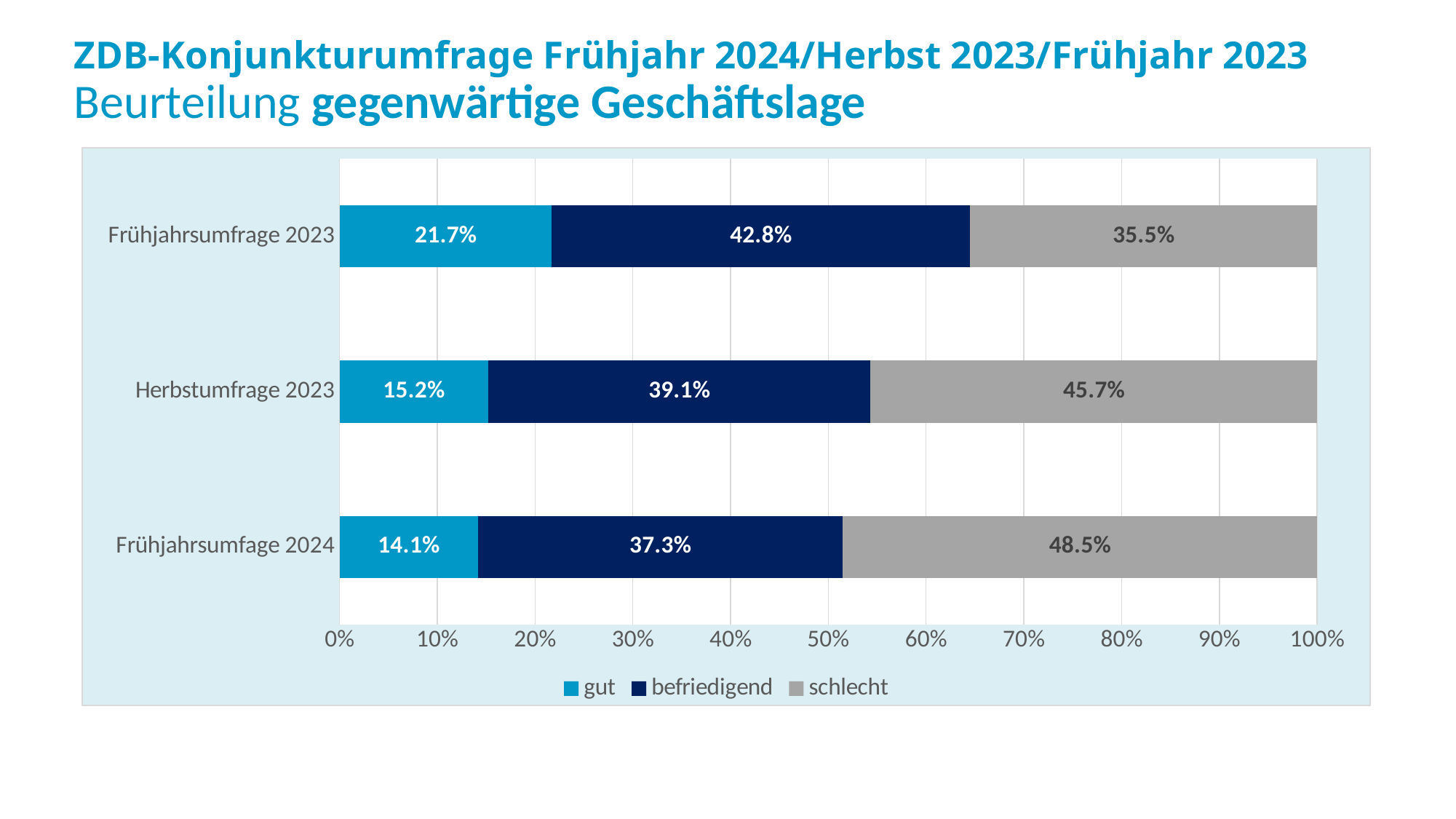
What is the value for "gut" in Frühjahrsumfrage 2023? 21.7% What kind of chart is shown on the slide? Stacked bar chart Which survey has the highest value for "schlecht"? Frühjahrsumfage 2024 What is the difference between the "schlecht" values for Frühjahrsumfage 2024 and Frühjahrsumfrage 2023? 13 percentage points What is the value for "schlecht" in Frühjahrsumfage 2024? 48.5% How many series does the legend list? 3 How many surveys (categories) are shown in the chart? 3 Which survey has the lowest value for "gut"? Frühjahrsumfage 2024 Does the "gut" share rise or fall from Frühjahrsumfrage 2023 to Frühjahrsumfage 2024? Fall Which colour represents "schlecht" in the chart? Grey What is the value for "befriedigend" in Herbstumfrage 2023? 39.1% Which is larger: the "gut" value for Herbstumfrage 2023 or for Frühjahrsumfage 2024? Herbstumfrage 2023